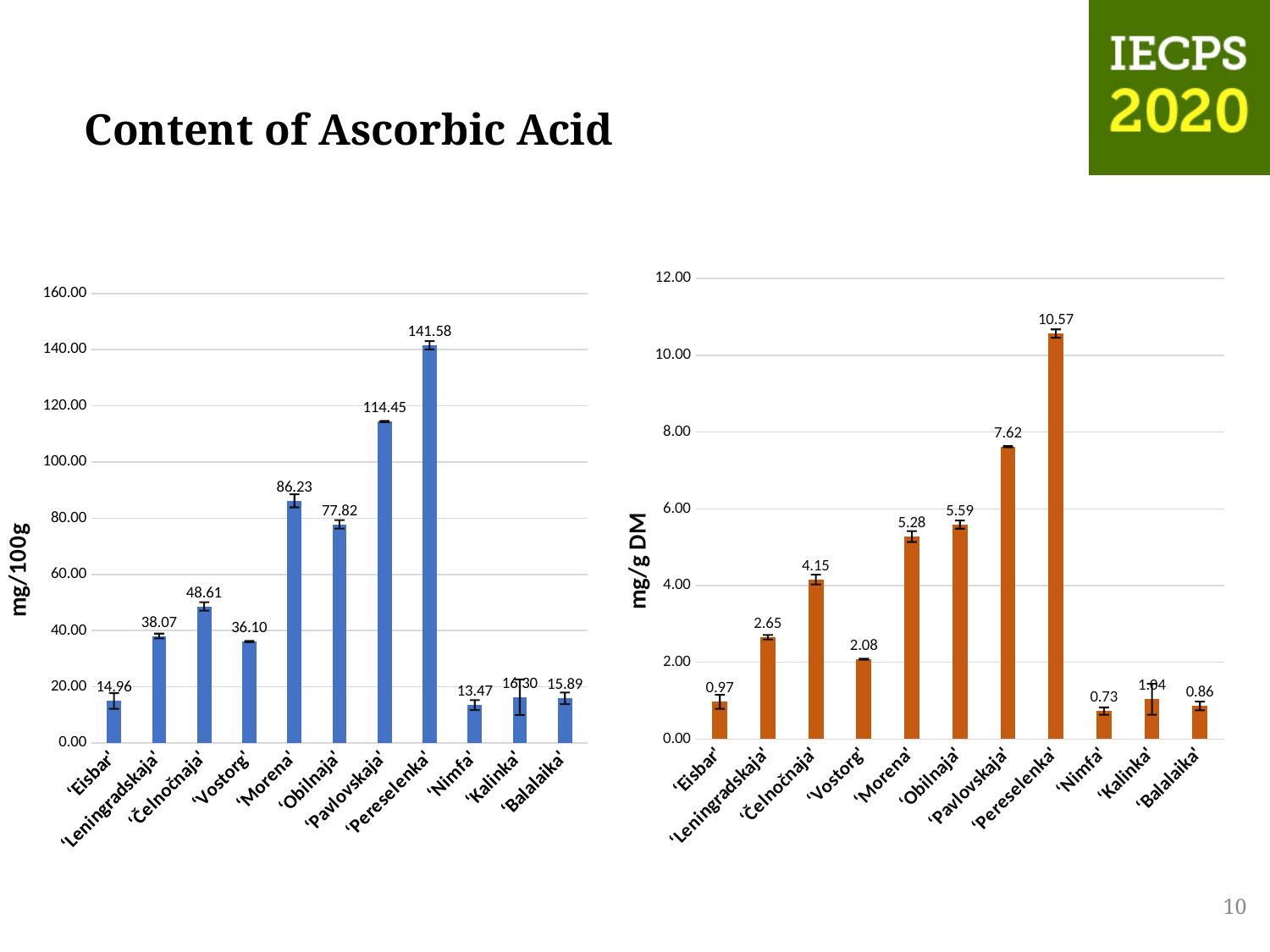
In the right chart (mg/g DM), what is the difference between the values for 'Pereselenka' and 'Pavlovskaja'? 2.95 In the left chart (mg/100g), what is the value for 'Pereselenka'? 141.58 What type of chart is the right chart (mg/g DM)? bar chart In the left chart (mg/100g), is the value for 'Pavlovskaja' greater or less than 100.00? greater In the left chart (mg/100g), what is the difference between the values for 'Morena' and 'Obilnaja'? 8.41 What is the y-axis label of the left chart? mg/100g In the right chart (mg/g DM), which is larger, the value for 'Čelnočnaja' or the value for 'Leningradskaja'? 'Čelnočnaja' How many cultivars are shown on the x axis of the left chart (mg/100g)? 11 What is the title of the slide? Content of Ascorbic Acid In the right chart (mg/g DM), which cultivar has the lowest value? 'Nimfa' In the right chart (mg/g DM), what is the value for 'Pavlovskaja'? 7.62 In the left chart (mg/100g), which cultivar has the highest ascorbic acid content? 'Pereselenka'